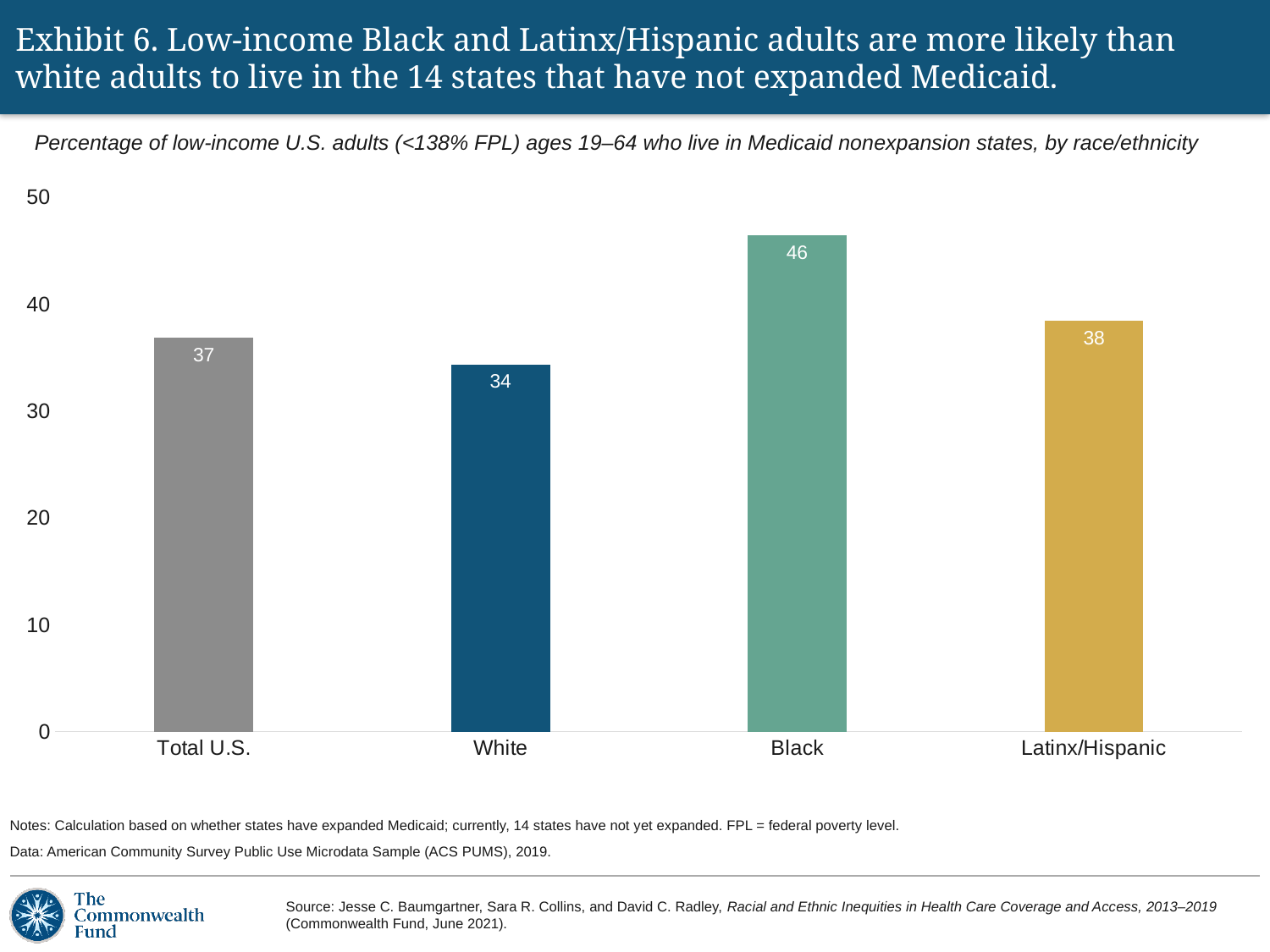
What is the highest value shown on the y axis? 50 Which is larger, the value for Latinx/Hispanic or the value for Total U.S.? Latinx/Hispanic Which category has the highest value? Black What kind of chart is shown on the slide? Bar chart What is the value for Latinx/Hispanic adults? 38 What is the difference between the values for Black and White adults? 12 What is the value for Black adults? 46 How many categories are shown on the x axis? 4 What is the value for Total U.S.? 37 Which category has the lowest value? White Is the value for Black adults greater or less than 40? greater What is the value for White adults? 34